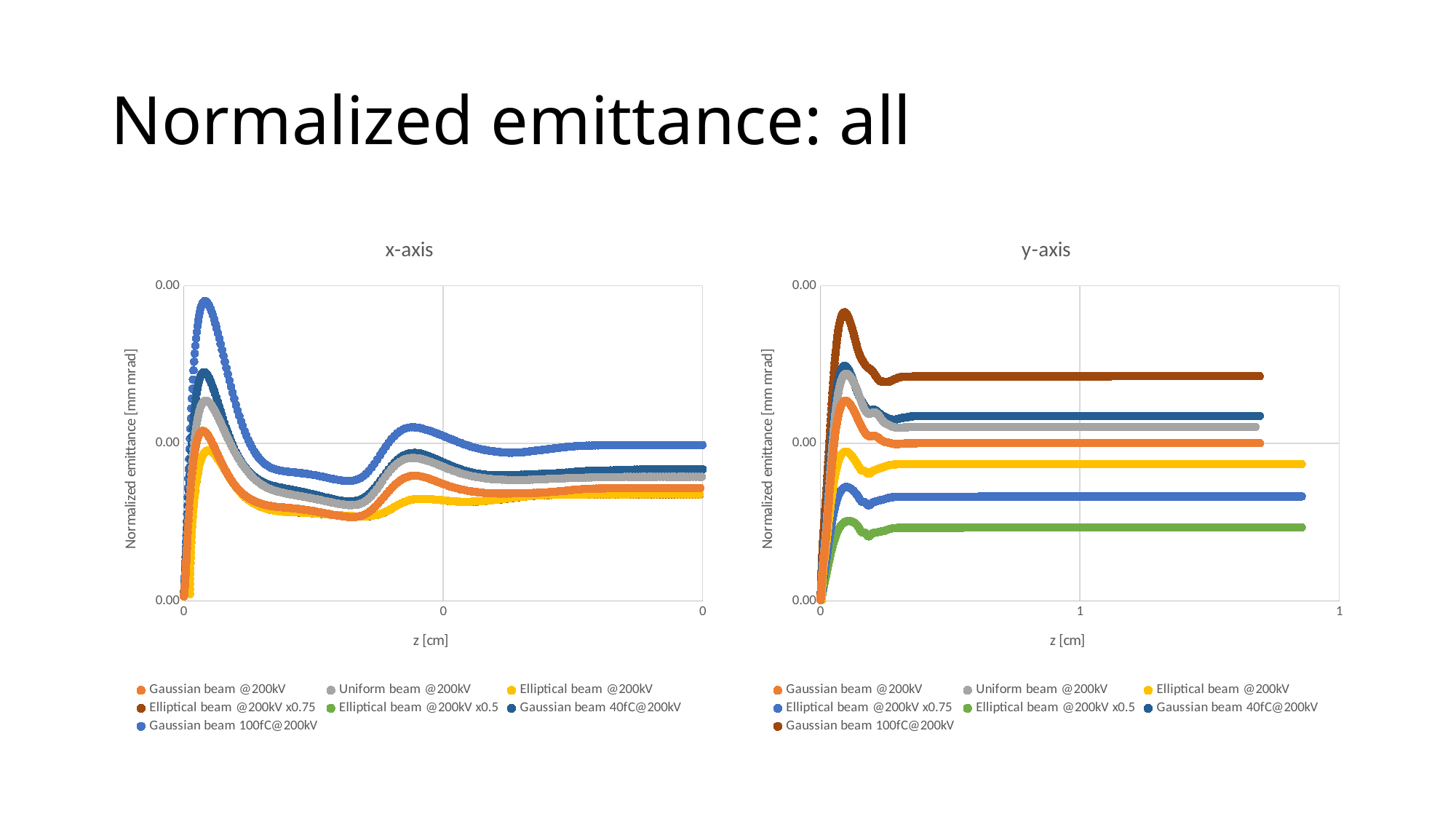
In the x-axis chart, which series reaches the highest peak in normalized emittance? Gaussian beam 100fC@200kV In the x-axis chart, is the final value of Gaussian beam 40fC@200kV larger or smaller than that of Gaussian beam 100fC@200kV? smaller In the y-axis chart, which series has the lowest normalized emittance at the right end of the plot? Elliptical beam @200kV x0.5 In the y-axis chart, how many series does the legend list? 7 In the x-axis chart, which series has the lowest normalized emittance at the right end of the plot? Elliptical beam @200kV In the y-axis chart, which series reaches the highest normalized emittance? Gaussian beam 100fC@200kV In the x-axis chart, how many series does the legend list? 7 What kind of chart is the y-axis chart? scatter chart In the y-axis chart, is the final value of Gaussian beam 100fC@200kV larger or smaller than that of Uniform beam @200kV? larger What kind of chart is the x-axis chart? scatter chart What is the title of the right chart? y-axis What is the title of the left chart? x-axis